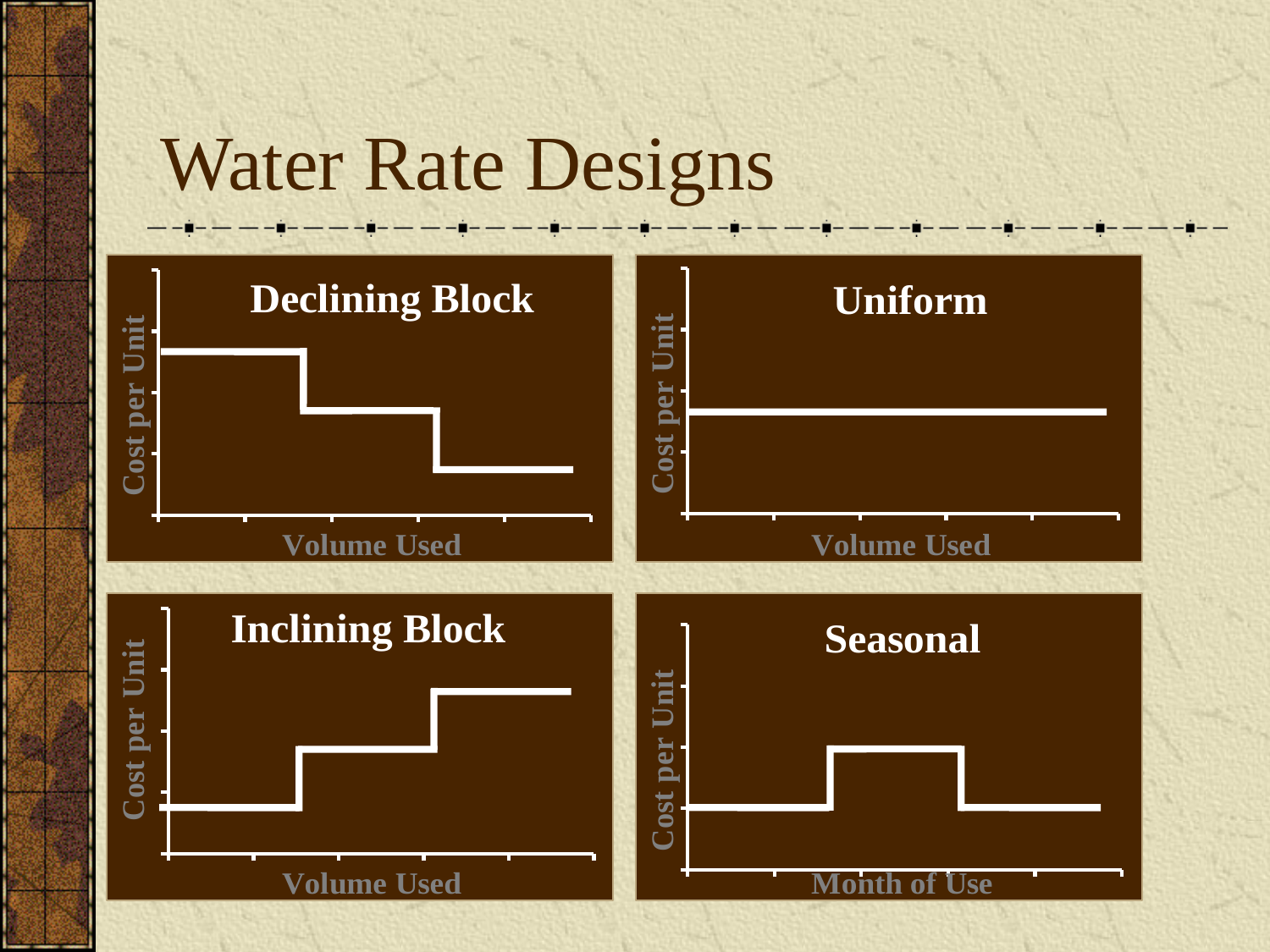
How many distinct price levels (steps) does the line in the "Inclining Block" chart show? 3 What is the y-axis label of the "Uniform" chart? Cost per Unit What kind of chart is the "Declining Block" chart? line chart In the "Uniform" chart, does cost per unit rise, fall, or stay flat as volume used increases? stay flat How many distinct price levels (steps) does the line in the "Declining Block" chart show? 3 Which chart on the slide has "Month of Use" rather than "Volume Used" on its x axis? Seasonal In the "Inclining Block" chart, does cost per unit rise or fall as volume used increases? rise What is the x-axis label of the "Seasonal" chart? Month of Use In the "Declining Block" chart, does cost per unit rise or fall as volume used increases? fall In the "Declining Block" chart, is the cost per unit for the first block higher or lower than for the last block? higher In the "Seasonal" chart, is the cost per unit in the middle months higher or lower than in the early and late months? higher How many charts are shown on the slide? 4